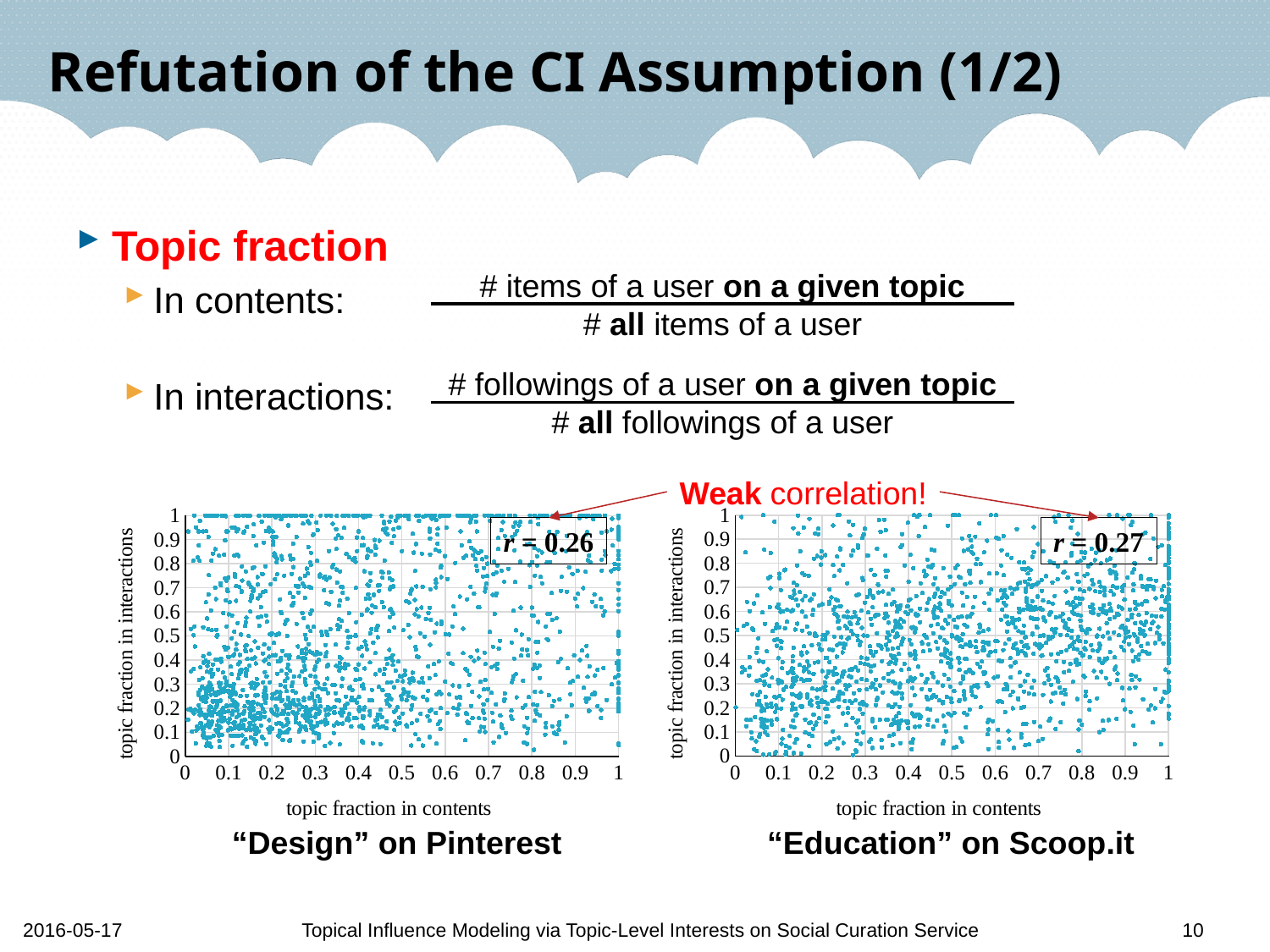
In the "Education" on Scoop.it chart, what is the label of the y axis? topic fraction in interactions In the "Design" on Pinterest chart, what is the label of the x axis? topic fraction in contents Which chart shows the higher correlation coefficient r, "Design" on Pinterest or "Education" on Scoop.it? "Education" on Scoop.it What kind of chart is the "Design" on Pinterest chart? scatter plot In the "Design" on Pinterest chart, what is the correlation coefficient r shown? r = 0.26 In the "Education" on Scoop.it chart, what is the correlation coefficient r shown? r = 0.27 How many scatter plots are shown on the slide? 2 What is the difference between the r values of the "Education" on Scoop.it chart and the "Design" on Pinterest chart? 0.01